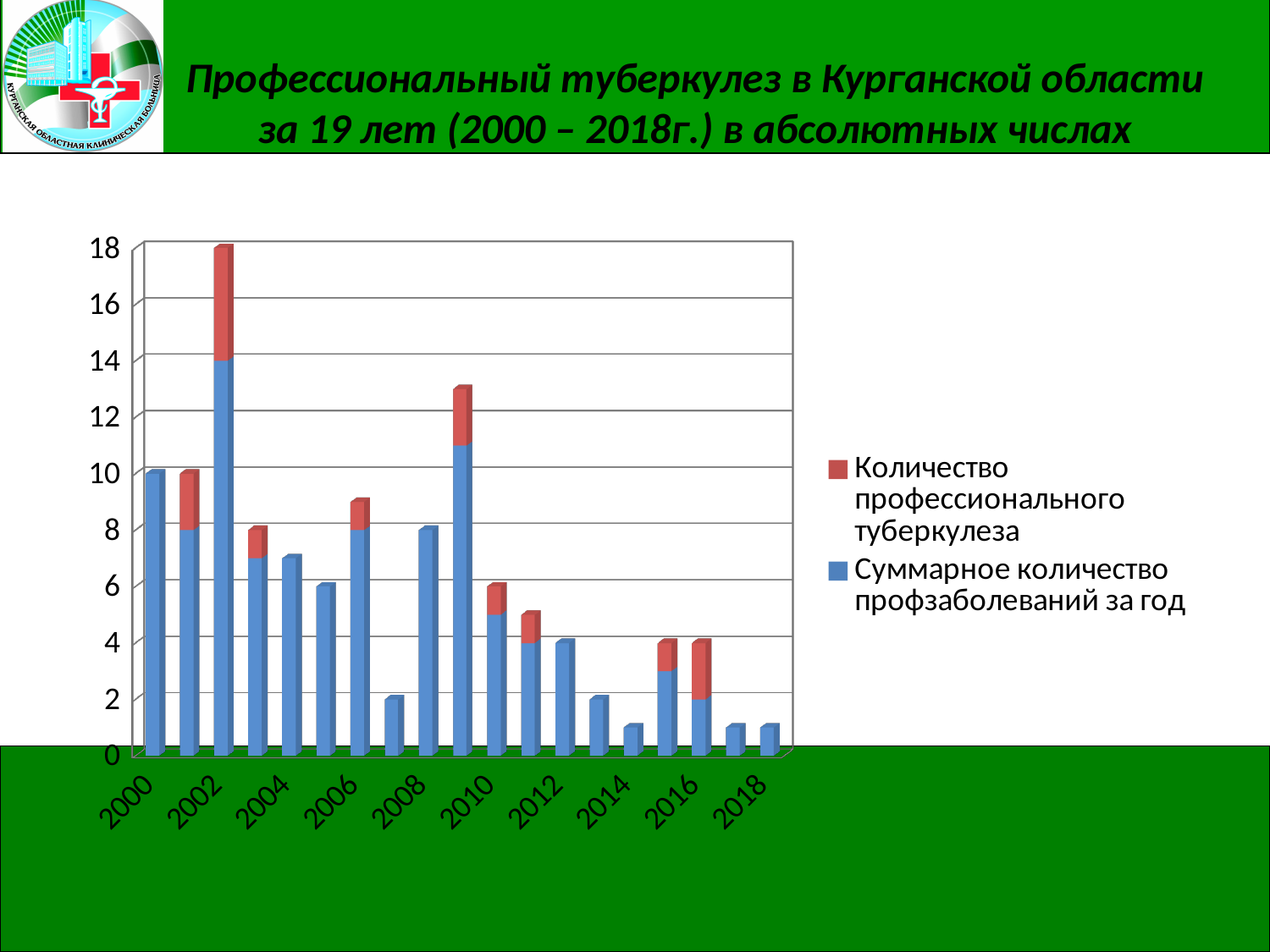
Is the total value for 2009 greater or less than 12? greater Which year has the tallest bar in the chart? 2002 What is the total height of the bar for 2000? 10 Which colour represents 'Количество профессионального туберкулеза' in the legend? red What is the total height of the bar for 2002? 18 Is the total value for 2014 greater or less than 2? less Do the bar heights generally rise or fall from 2009 to 2018? fall Which bar is taller, 2000 or 2004? 2000 How many series does the legend list? 2 What is the total height of the bar for 2013? 2 What kind of chart is shown on the slide? bar chart How many bars (years) are plotted in the chart? 19